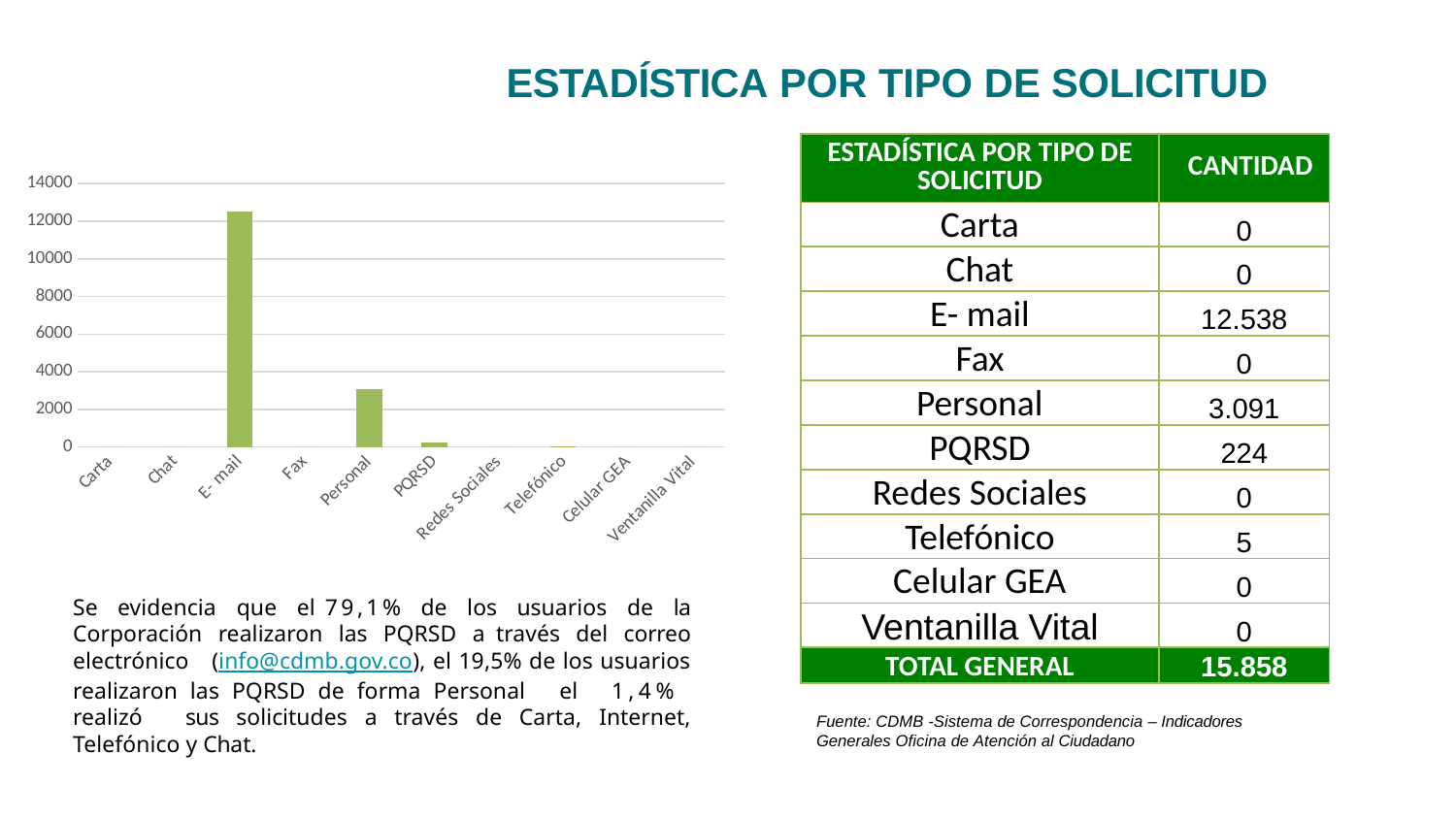
Which is larger, the bar for Personal or the bar for PQRSD? Personal What kind of chart is shown on the slide? bar chart What is the highest tick value shown on the y axis of the chart? 14000 According to the table next to the chart, what is the quantity for Personal? 3.091 According to the table next to the chart, what is the quantity for E- mail? 12.538 How many categories are shown on the x axis of the bar chart? 10 Is the value for Personal greater or less than 2000? greater Is the value for Personal greater or less than 4000? less Is the value for E- mail greater or less than 12000? greater Which category has the highest bar in the chart? E- mail Which is larger, the bar for E- mail or the bar for Personal? E- mail According to the table next to the chart, what is the quantity for PQRSD? 224